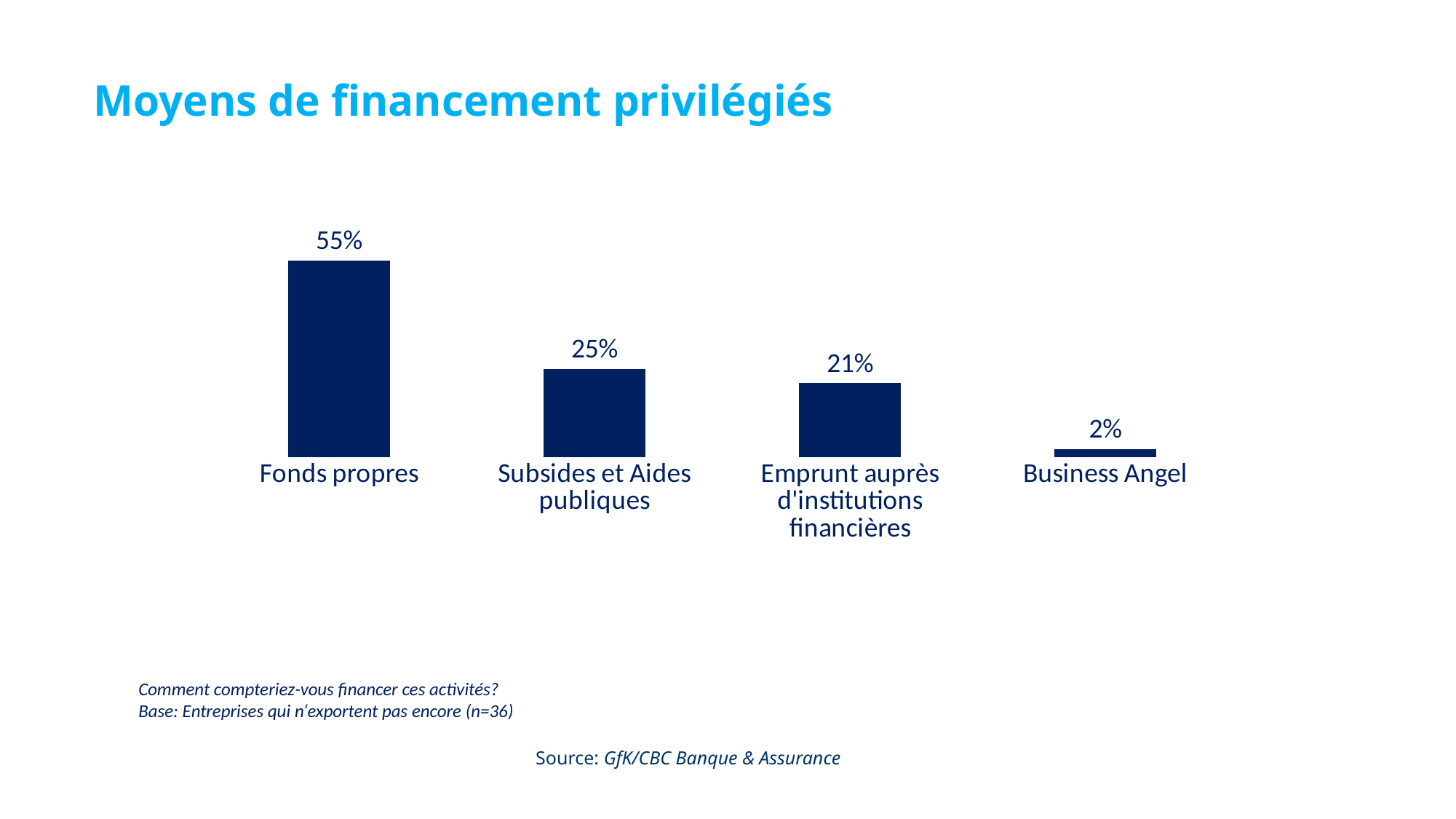
What is the value for Fonds propres? 55% What is the title of the slide? Moyens de financement privilégiés Which category has the lowest value? Business Angel What is the value for Emprunt auprès d'institutions financières? 21% How many categories are shown in the chart? 4 What is the value for Subsides et Aides publiques? 25% What is the value for Business Angel? 2% What kind of chart is shown on the slide? Bar chart What is the difference between the values for Fonds propres and Subsides et Aides publiques? 30% Which is larger, the value for Subsides et Aides publiques or the value for Emprunt auprès d'institutions financières? Subsides et Aides publiques What is the difference between the values for Emprunt auprès d'institutions financières and Business Angel? 19% Which category has the highest value? Fonds propres